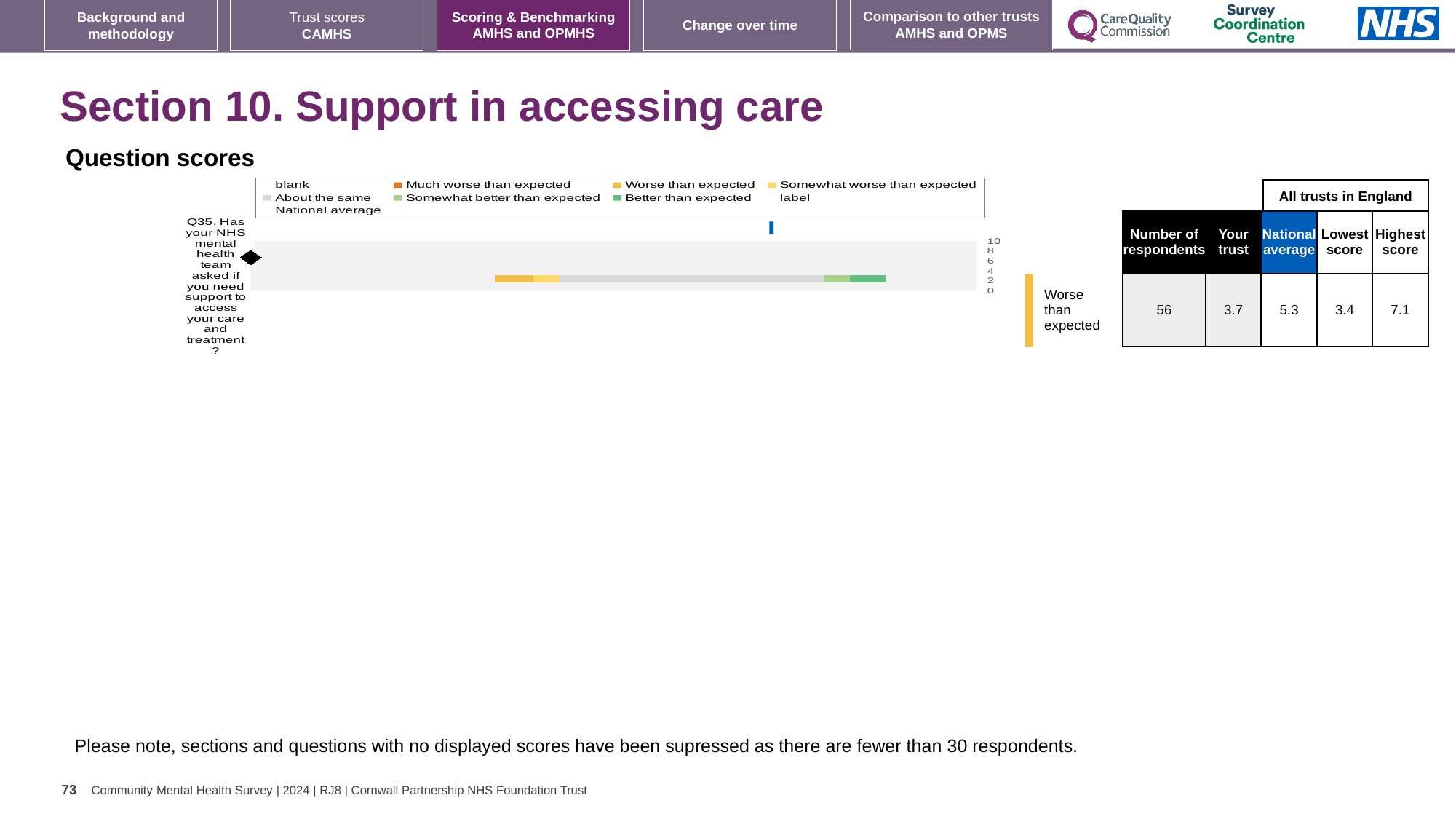
What is the lowest score among all trusts in England for Q35? 3.4 What is the highest score among all trusts in England for Q35? 7.1 What is the highest value shown on the chart's axis? 10 What is the 'Your trust' score for Q35? 3.7 What is the difference between the highest score and the lowest score for Q35? 3.7 What benchmark category is Q35 labelled with next to the chart? Worse than expected What kind of chart is shown under 'Question scores'? bar chart Which is larger for Q35, the 'Your trust' score or the national average? National average What is the national average score for Q35? 5.3 What is the number of respondents for Q35? 56 Which question is plotted in the Question scores chart? Q35. Has your NHS mental health team asked if you need support to access your care and treatment? How many questions are plotted in the Question scores chart? 1